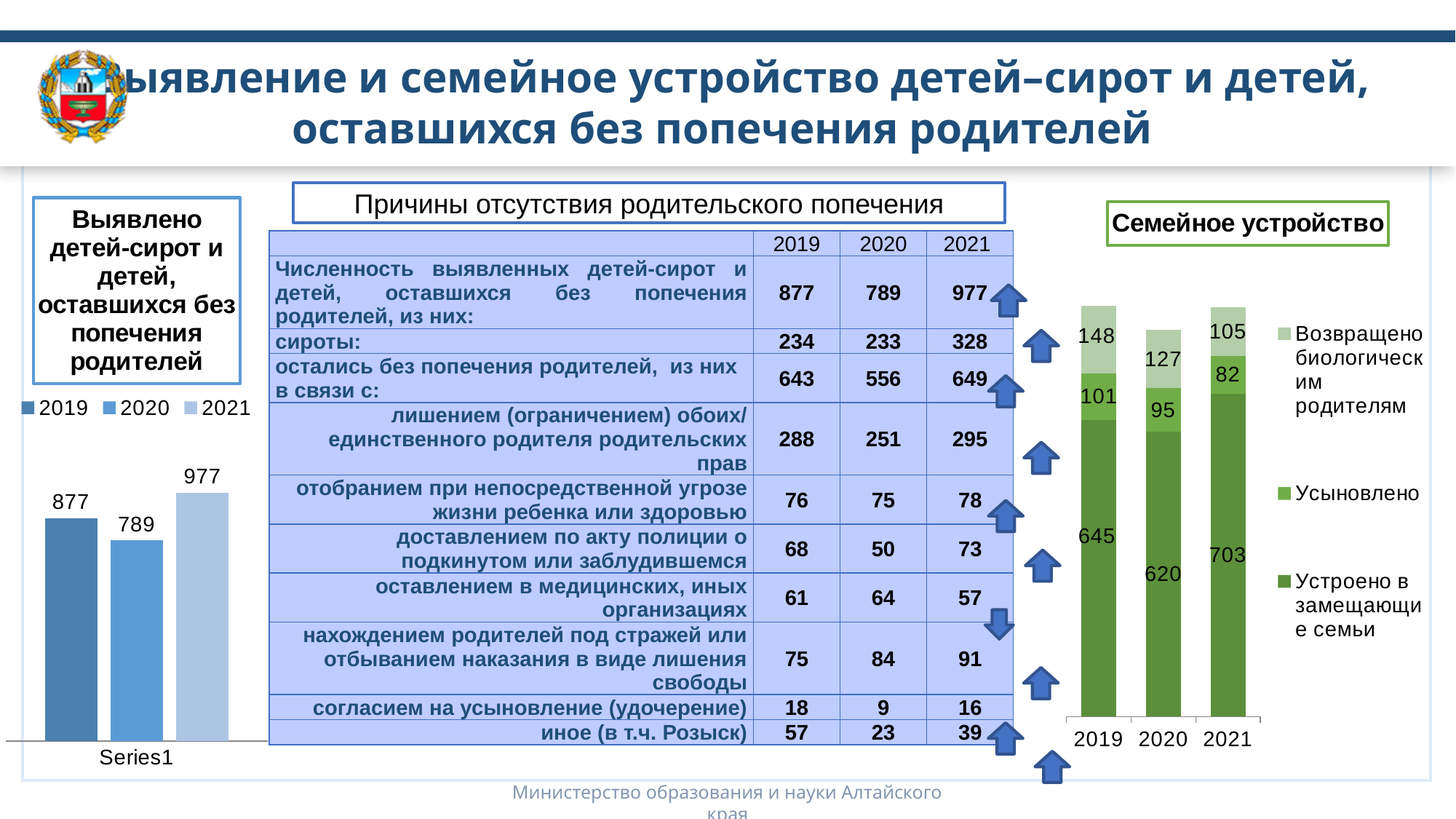
In the right chart 'Семейное устройство', does the value for 'Усыновлено' rise or fall from 2019 to 2021? fall In the left chart 'Выявлено детей-сирот и детей, оставшихся без попечения родителей', how many series does the legend list? 3 In the right chart 'Семейное устройство', what is the value for 'Возвращено биологическим родителям' in 2019? 148 In the left chart 'Выявлено детей-сирот и детей, оставшихся без попечения родителей', which year has the lowest value? 2020 In the left chart 'Выявлено детей-сирот и детей, оставшихся без попечения родителей', what is the value for 2021? 977 In the right chart 'Семейное устройство', how many years are shown on the x axis? 3 In the right chart 'Семейное устройство', what is the total of the stacked bar for 2020? 842 In the right chart 'Семейное устройство', which year has the highest value for 'Усыновлено'? 2019 In the right chart 'Семейное устройство', is the value for 'Устроено в замещающие семьи' larger in 2019 or in 2020? 2019 What type of chart is the left chart 'Выявлено детей-сирот и детей, оставшихся без попечения родителей'? bar chart In the left chart 'Выявлено детей-сирот и детей, оставшихся без попечения родителей', what is the difference between the 2021 and 2019 values? 100 In the right chart 'Семейное устройство', what is the value for 'Устроено в замещающие семьи' in 2021? 703